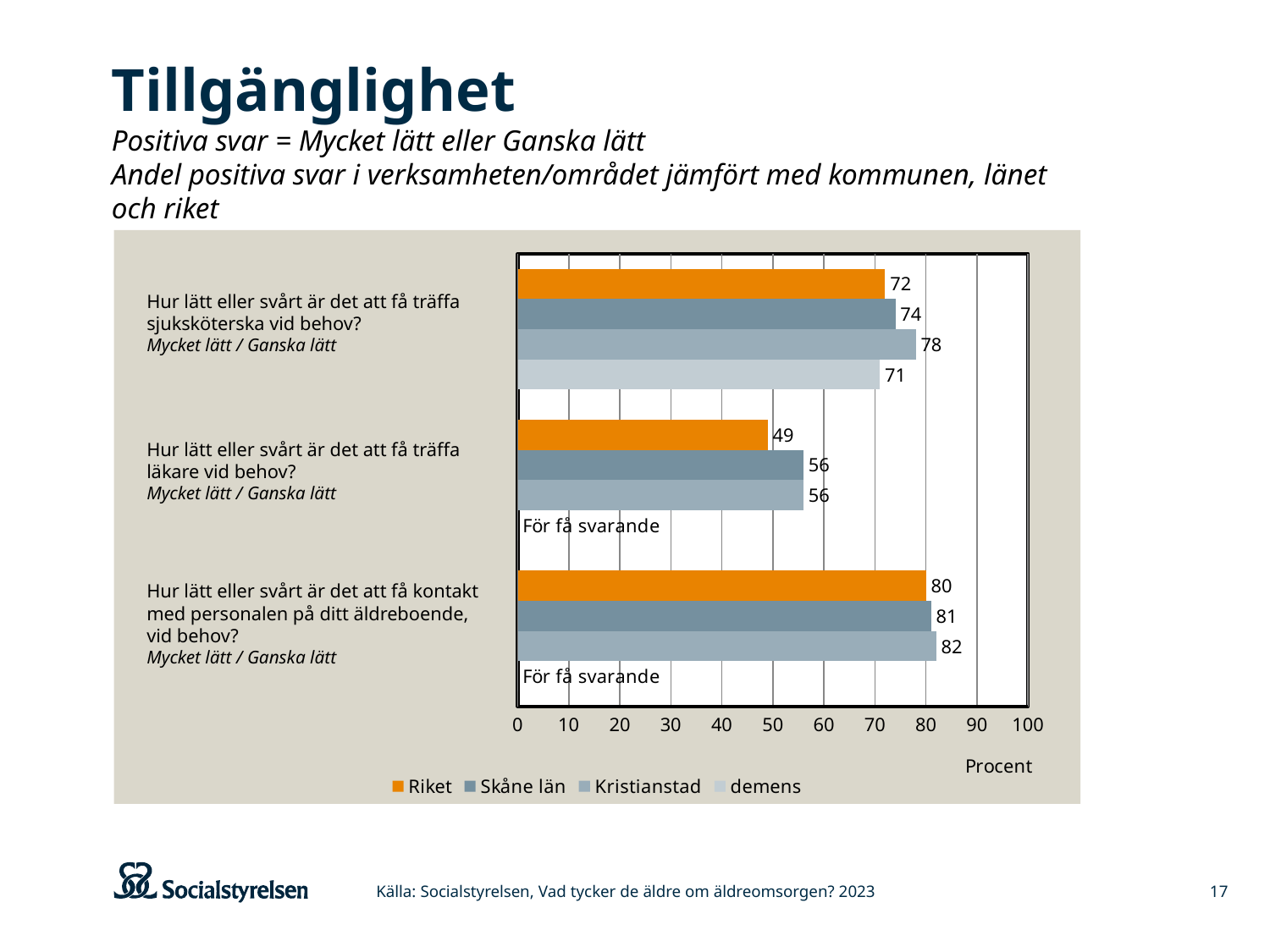
What kind of chart is shown on the slide? Bar chart How many series does the legend list? 4 What is the difference between Kristianstad and Riket on the question about meeting a nurse (sjuksköterska) when needed? 6 What is the difference between Skåne län and Riket on the question about meeting a doctor (läkare) when needed? 7 Which series has the highest value on the question about meeting a nurse (sjuksköterska) when needed? Kristianstad What is shown for the demens series on the question about meeting a doctor (läkare) when needed? För få svarande What is the value for Riket on the question about meeting a doctor (läkare) when needed? 49 What is the value for Kristianstad on the question about meeting a nurse (sjuksköterska) when needed? 78 What is the value for Skåne län on the question about getting in contact with staff at the care home (kontakt med personalen)? 81 What is the value for demens on the question about meeting a nurse (sjuksköterska) when needed? 71 Which is larger on the question about getting in contact with staff: Kristianstad or Riket? Kristianstad Which series has the lowest value on the question about meeting a doctor (läkare) when needed? Riket